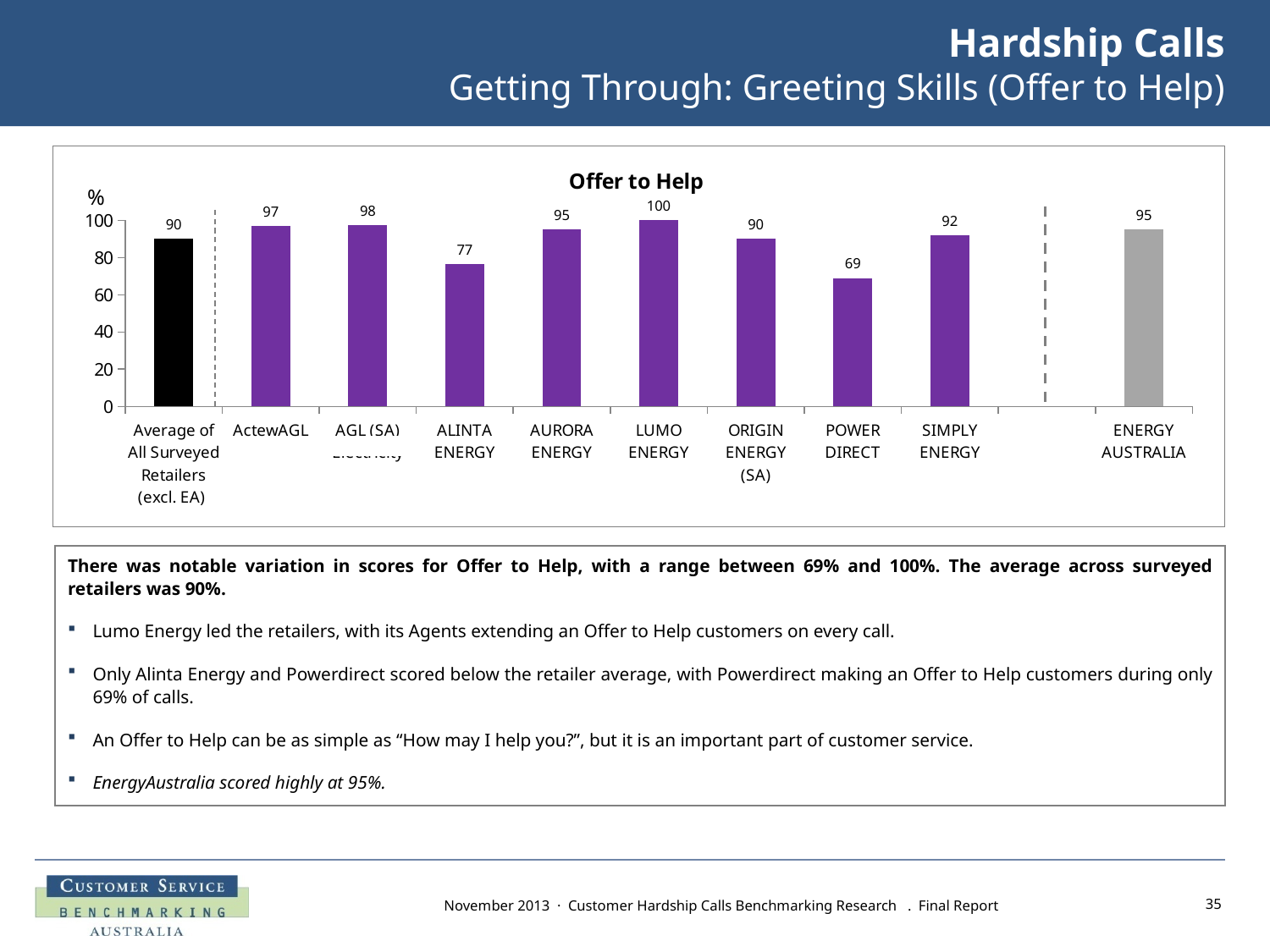
How many bars are shown in the Offer to Help chart? 10 What type of chart is the Offer to Help chart? Bar chart What is the title of the chart on the slide? Offer to Help Which retailer has the lowest value in the Offer to Help chart? POWER DIRECT What is the value for POWER DIRECT in the Offer to Help chart? 69 What is the value for ENERGY AUSTRALIA in the Offer to Help chart? 95 What is the value for LUMO ENERGY in the Offer to Help chart? 100 What is the difference between the values for ActewAGL and ALINTA ENERGY in the Offer to Help chart? 20 What is the value for the Average of All Surveyed Retailers (excl. EA) in the Offer to Help chart? 90 Is the value for ALINTA ENERGY in the Offer to Help chart greater or less than 80? less Which retailer has the highest value in the Offer to Help chart? LUMO ENERGY Which has a higher value in the Offer to Help chart, SIMPLY ENERGY or AURORA ENERGY? AURORA ENERGY